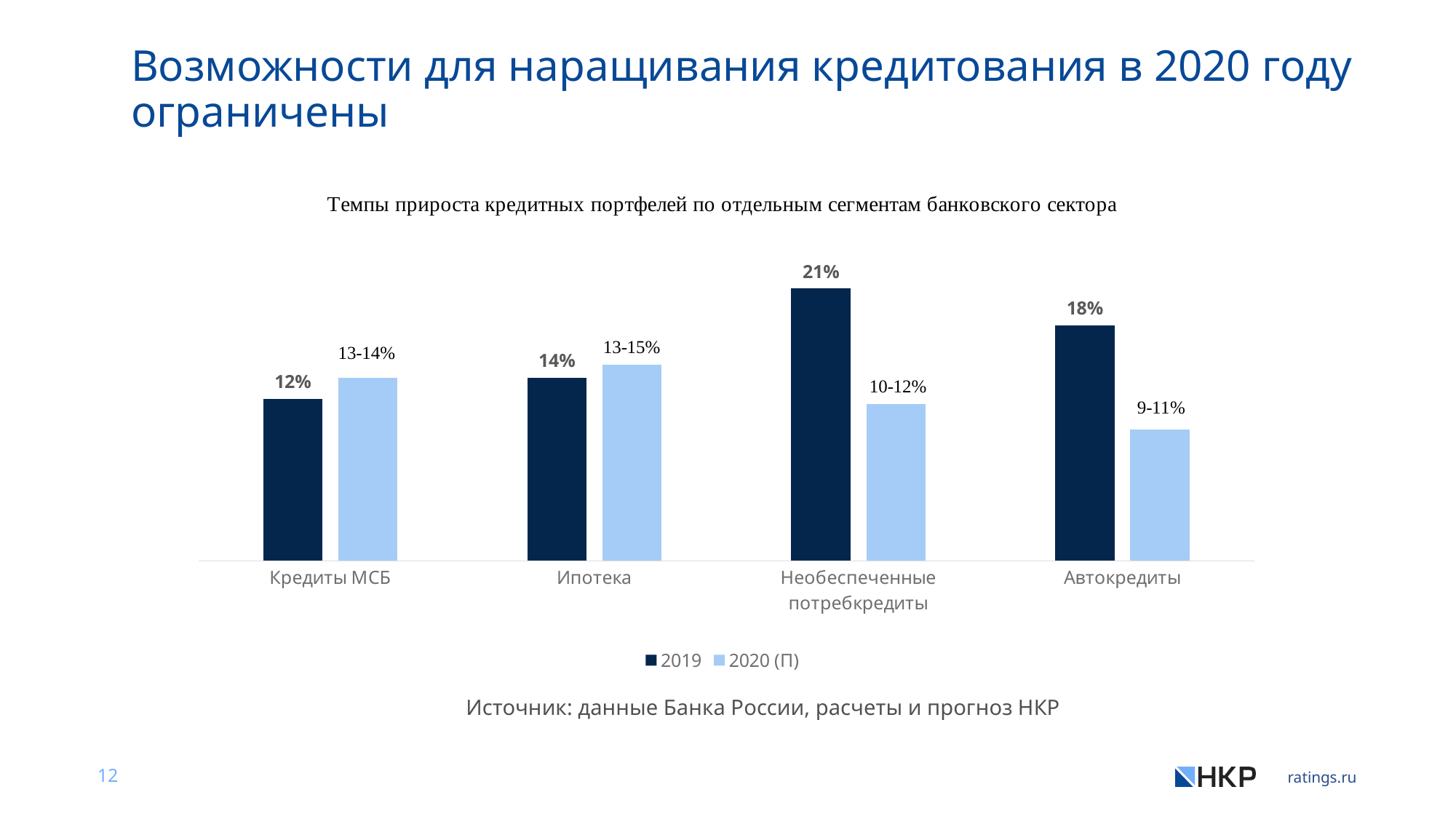
Which is larger: the 2019 value for Ипотека or the 2019 value for Автокредиты? Автокредиты Which category has the highest 2019 value? Необеспеченные потребкредиты How many series does the legend list? 2 What is the 2019 value for Необеспеченные потребкредиты? 21% Which category has the lowest 2019 value? Кредиты МСБ What is the title of the chart? Темпы прироста кредитных портфелей по отдельным сегментам банковского сектора What kind of chart is shown on the slide? Bar chart What is the 2019 value for Кредиты МСБ? 12% How many categories are shown on the x axis? 4 What is the difference between the 2019 values for Необеспеченные потребкредиты and Автокредиты? 3% What is the 2020 (П) value for Автокредиты? 9-11% What is the 2020 (П) value for Ипотека? 13-15%